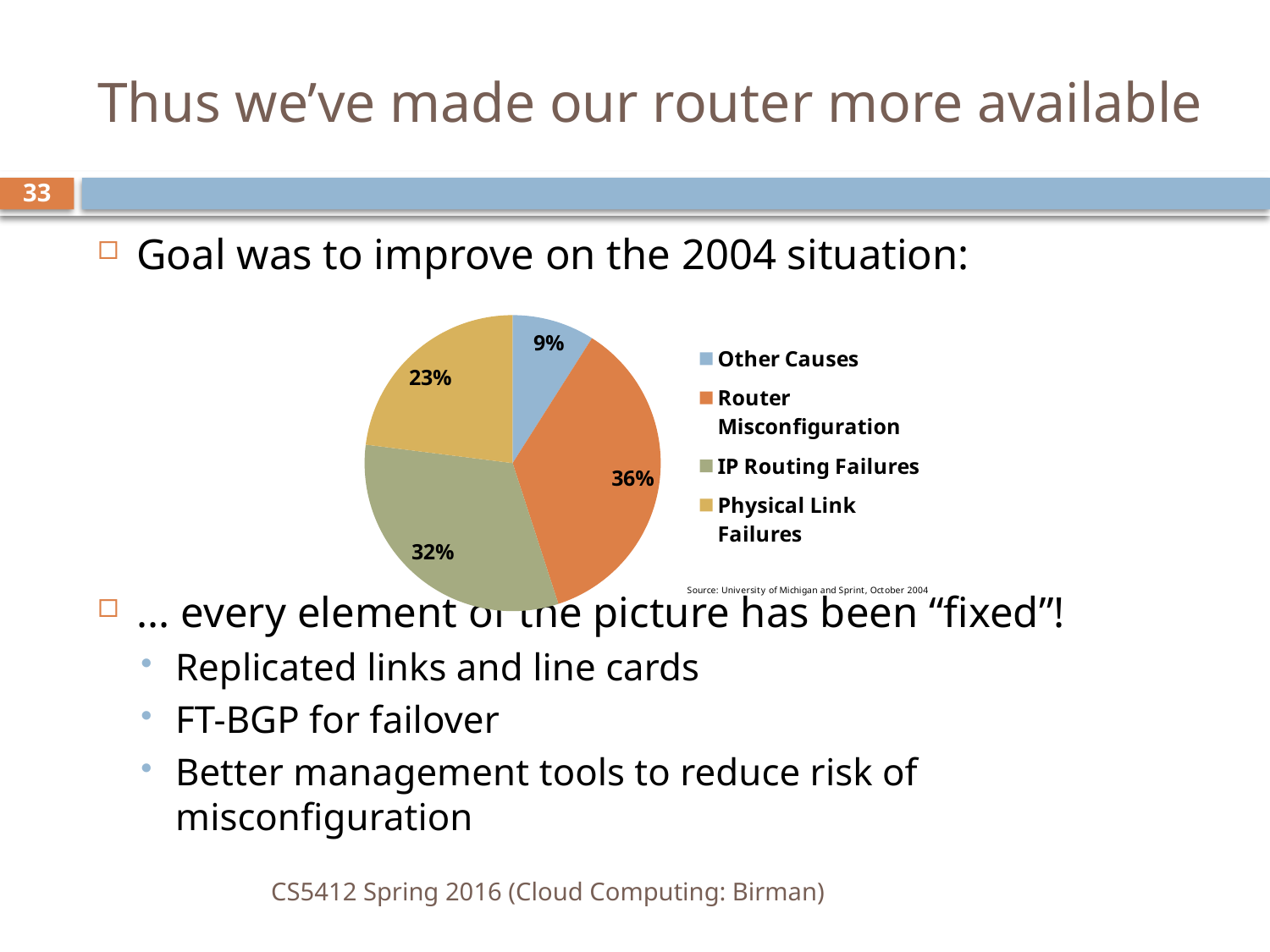
What share of the pie is IP Routing Failures? 32% Which category has the smallest slice of the pie? Other Causes Which category has the largest slice of the pie? Router Misconfiguration Which is larger, the share for IP Routing Failures or the share for Physical Link Failures? IP Routing Failures How many categories does the pie chart have? 4 What is the difference in percentage points between Router Misconfiguration and Physical Link Failures? 13 What type of chart is shown on the slide? pie chart What share of the pie is Router Misconfiguration? 36% What share of the pie is Other Causes? 9% What source is cited below the chart? University of Michigan and Sprint, October 2004 What colour is the slice for Physical Link Failures? yellow